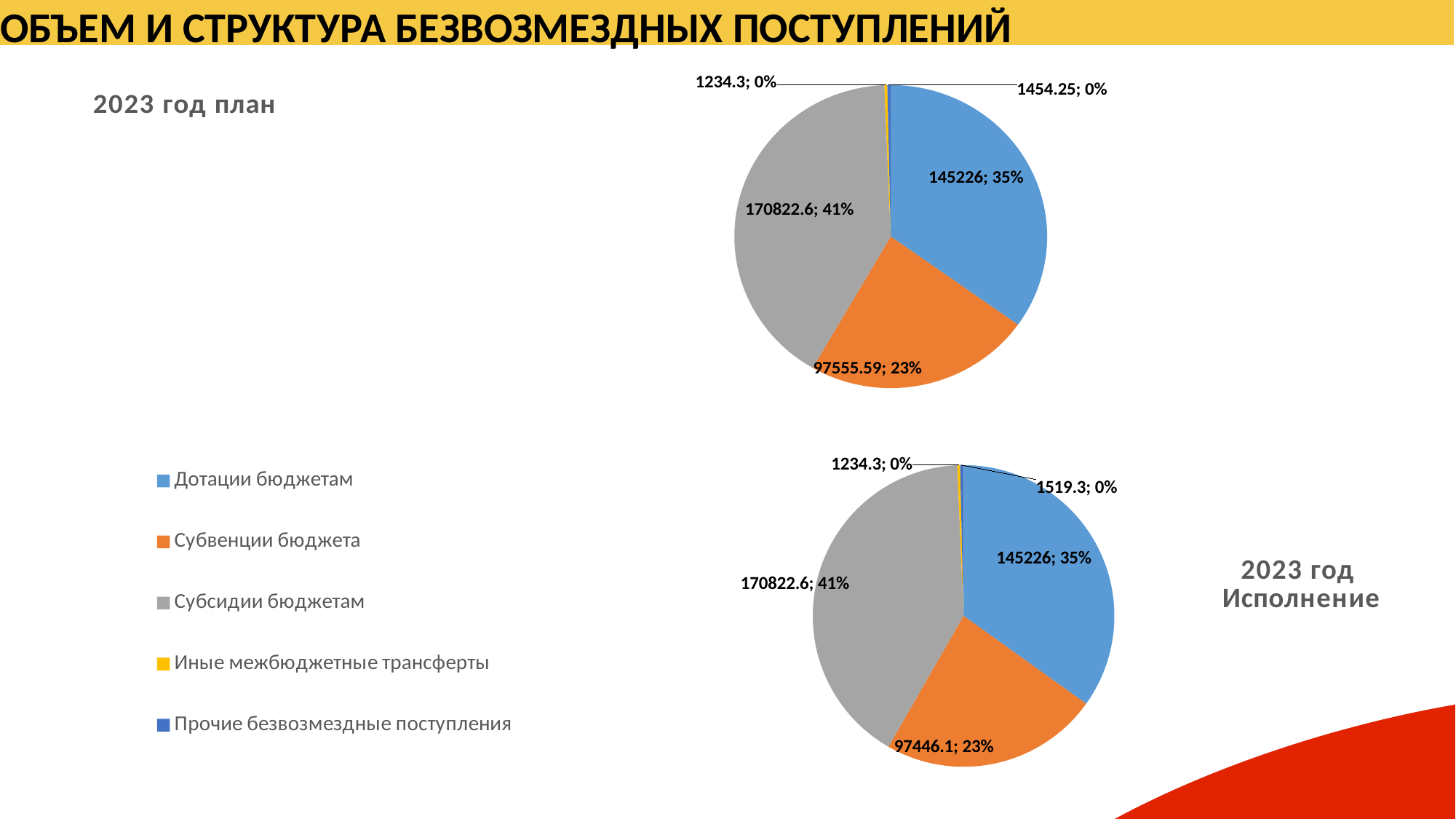
In the '2023 год план' chart, which category has the largest slice? Субсидии бюджетам What type of chart is used on this slide? Pie chart In the '2023 год план' chart, what value is shown for Субсидии бюджетам? 170822.6 In the '2023 год Исполнение' chart, what share of the pie is Субсидии бюджетам? 41% In the '2023 год Исполнение' chart, what value is shown for Прочие безвозмездные поступления? 1519.3 In the '2023 год план' chart, what value is shown for Субвенции бюджета? 97555.59 In the '2023 год план' chart, what share of the pie is Дотации бюджетам? 35% In the '2023 год Исполнение' chart, which category has the smallest slice? Иные межбюджетные трансферты In the '2023 год Исполнение' chart, what value is shown for Субвенции бюджета? 97446.1 In the '2023 год план' chart, what is the difference between the values for Субсидии бюджетам and Дотации бюджетам? 25596.6 In the '2023 год Исполнение' chart, which is larger: Дотации бюджетам or Субвенции бюджета? Дотации бюджетам How many categories does the legend list? 5